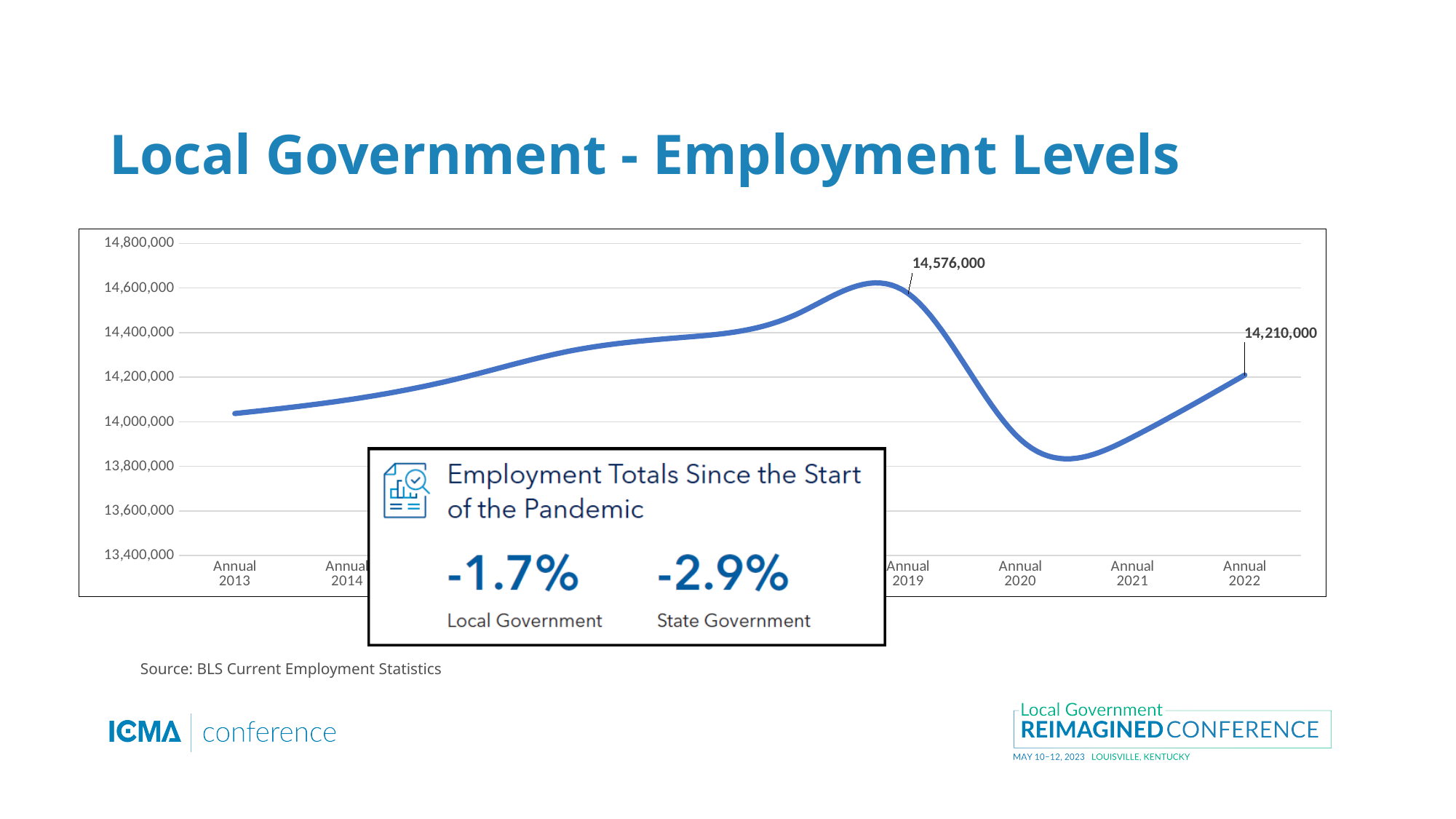
What kind of chart is shown on the slide? line chart Does the employment level rise or fall from Annual 2020 to Annual 2022? rise Which is larger, the employment level for Annual 2019 or Annual 2022? Annual 2019 What is the difference between the Annual 2019 and Annual 2022 employment levels? 366,000 What is the employment level for Annual 2022? 14,210,000 Does the employment level rise or fall from Annual 2019 to Annual 2020? fall Is the value for Annual 2020 greater or less than 14,000,000? less What is the employment level for Annual 2019? 14,576,000 Which year shows the highest employment level on the chart? Annual 2019 What is the title of the slide containing the chart? Local Government - Employment Levels Is the value for Annual 2013 greater or less than 14,200,000? less